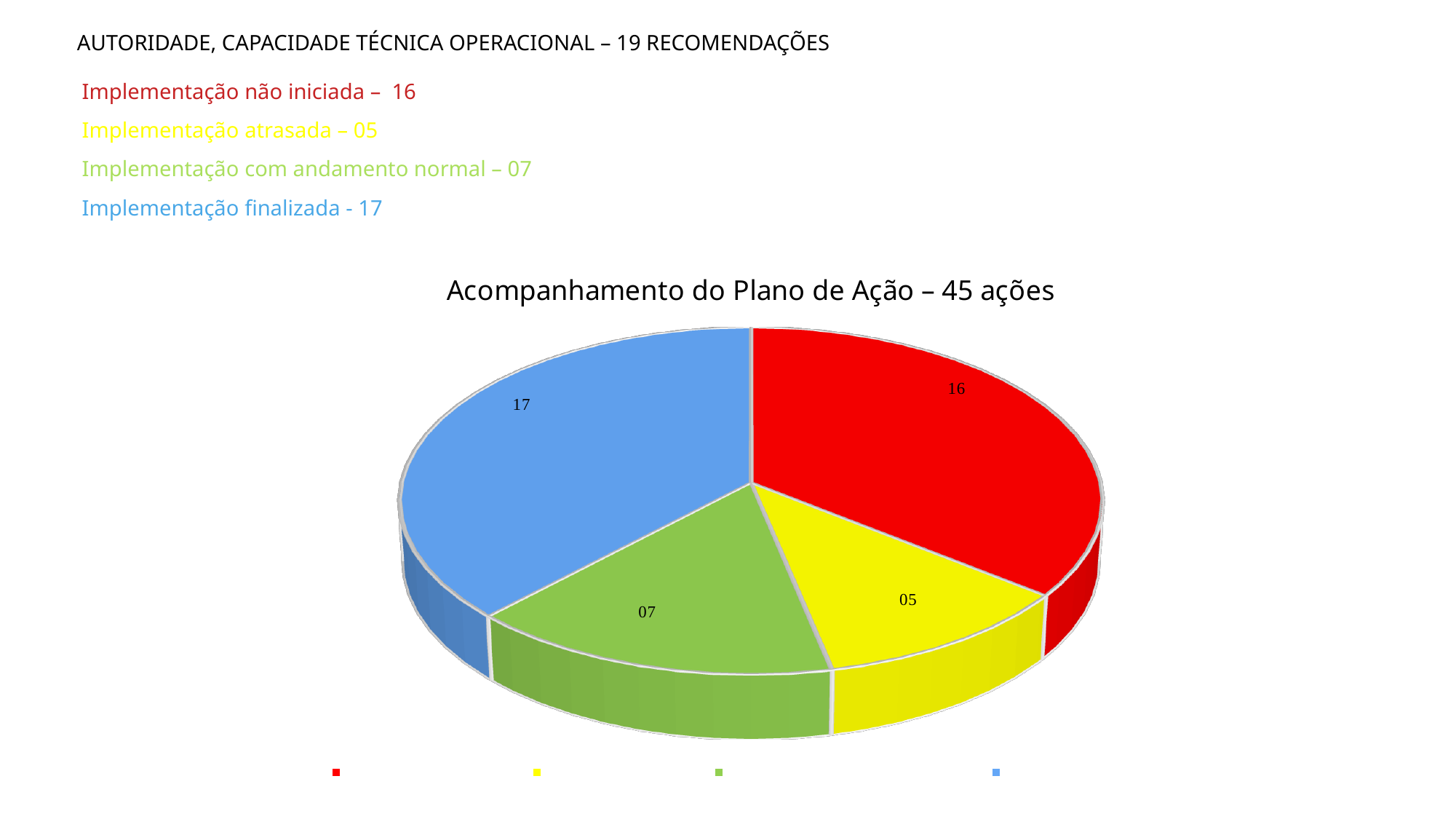
What kind of chart is shown on the slide? pie chart Which is larger, the value of the green slice or the value of the yellow slice? the green slice What is the difference between the values of the red slice and the yellow slice? 11 What value is shown on the green slice of the pie chart? 07 What value is shown on the yellow slice of the pie chart? 05 Which slice of the pie chart has the largest value? the blue slice (17) What value is shown on the blue slice of the pie chart? 17 What is the total of all the values shown on the pie chart? 45 How many slices does the pie chart have? 4 What is the title of the chart? Acompanhamento do Plano de Ação – 45 ações Which slice of the pie chart has the smallest value? the yellow slice (05) What value is shown on the red slice of the pie chart? 16